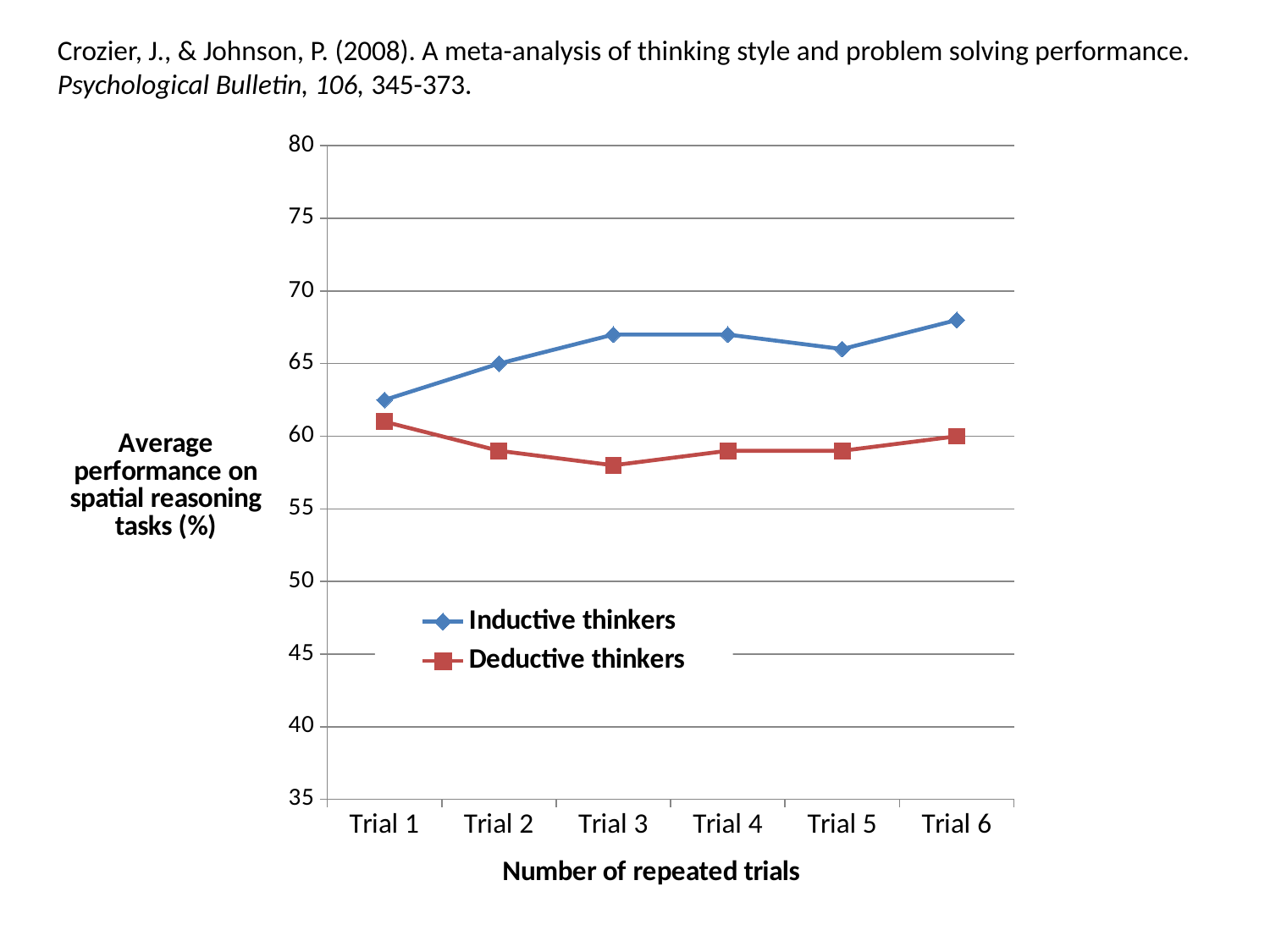
How many trials are shown on the x axis? 6 At which trial do Inductive thinkers reach their highest value? Trial 6 What kind of chart is shown on the slide? line chart Is the value for Inductive thinkers at Trial 1 greater or less than 60? greater Is the value for Inductive thinkers at Trial 6 greater or less than 65? greater Which series has the higher value at Trial 4, Inductive thinkers or Deductive thinkers? Inductive thinkers Is the value for Deductive thinkers at Trial 3 greater or less than 60? less What is the label of the x axis? Number of repeated trials What is the value for Inductive thinkers at Trial 2? 65 At which trial do Deductive thinkers have their lowest value? Trial 3 How many series does the legend list? 2 What is the value for Deductive thinkers at Trial 6? 60